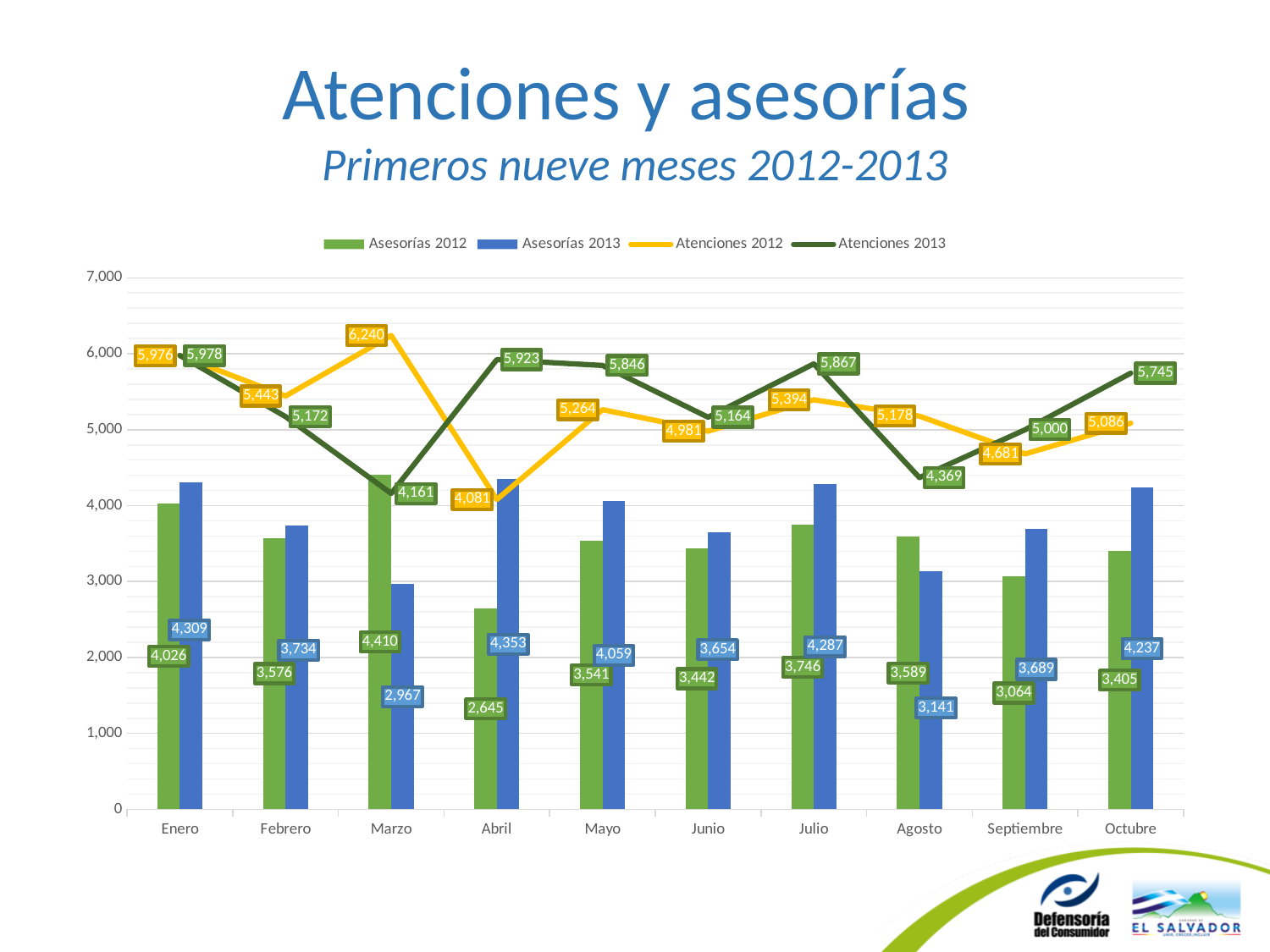
In Julio, which is larger: Asesorías 2012 or Asesorías 2013? Asesorías 2013 What is the difference between Atenciones 2012 in Marzo and in Abril? 2,159 What is the value of Atenciones 2012 in Septiembre? 4,681 What kind of chart is shown on the slide? Combined bar and line chart In which month is Asesorías 2012 lowest? Abril What is the difference between Asesorías 2013 and Asesorías 2012 in Abril? 1,708 In which month is Atenciones 2012 highest? Marzo What is the value of Asesorías 2012 in Marzo? 4,410 In which month is Atenciones 2013 lowest? Marzo What is the value of Atenciones 2013 in Abril? 5,923 How many series does the legend list? 4 How many months are shown on the x axis? 10